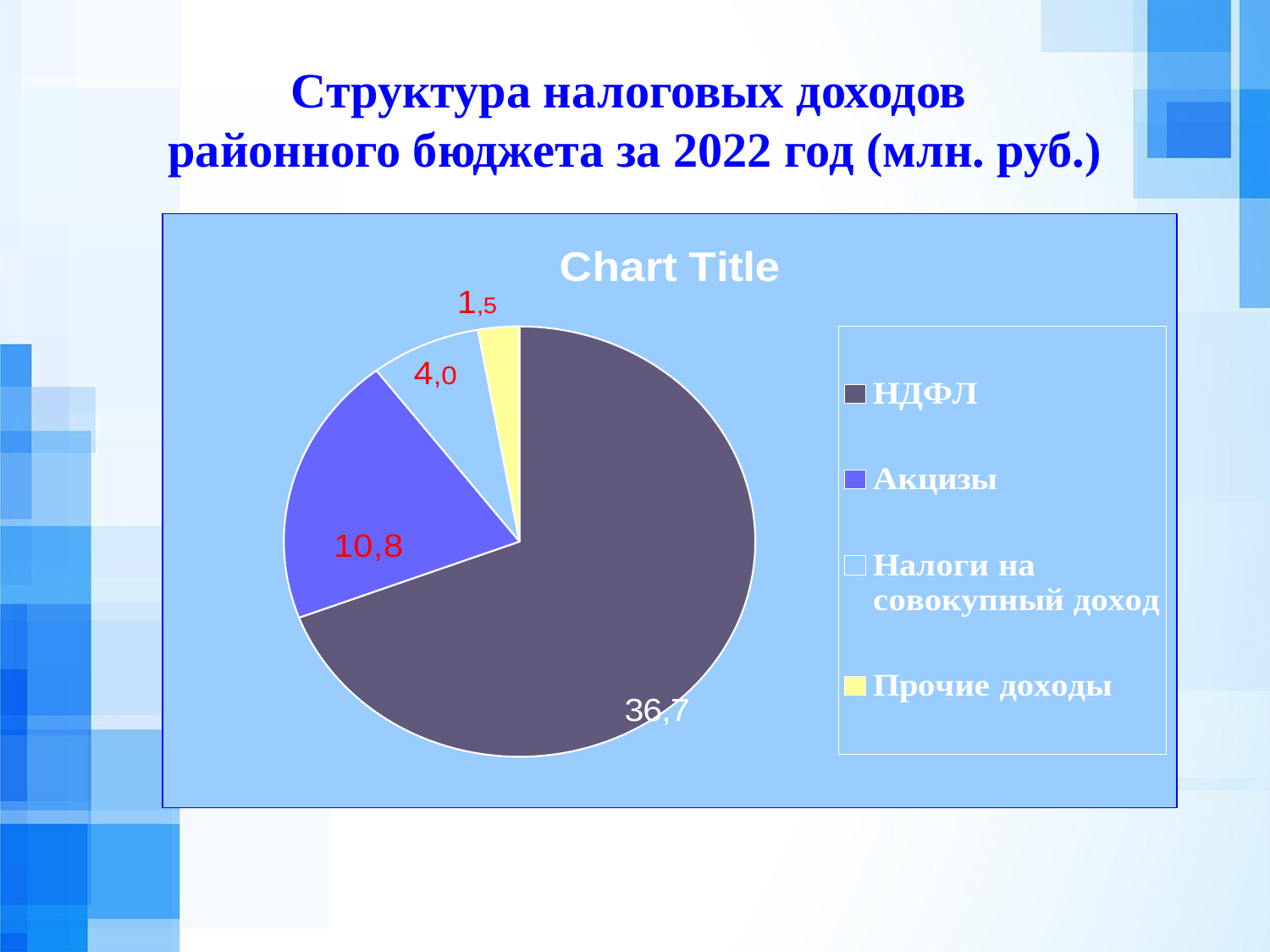
What is the difference between the values for НДФЛ and Акцизы? 25,9 What is the value for Налоги на совокупный доход? 4,0 What is the value for Акцизы? 10,8 Which category has the largest slice of the pie? НДФЛ What is the value for НДФЛ? 36,7 What is the value for Прочие доходы? 1,5 Which is larger, the value for Акцизы or the value for Налоги на совокупный доход? Акцизы What is the total of all slices in the pie chart? 53,0 Which category has the smallest slice of the pie? Прочие доходы How many slices does the pie chart have? 4 What colour is the slice for Прочие доходы? Yellow What kind of chart is shown on the slide? Pie chart